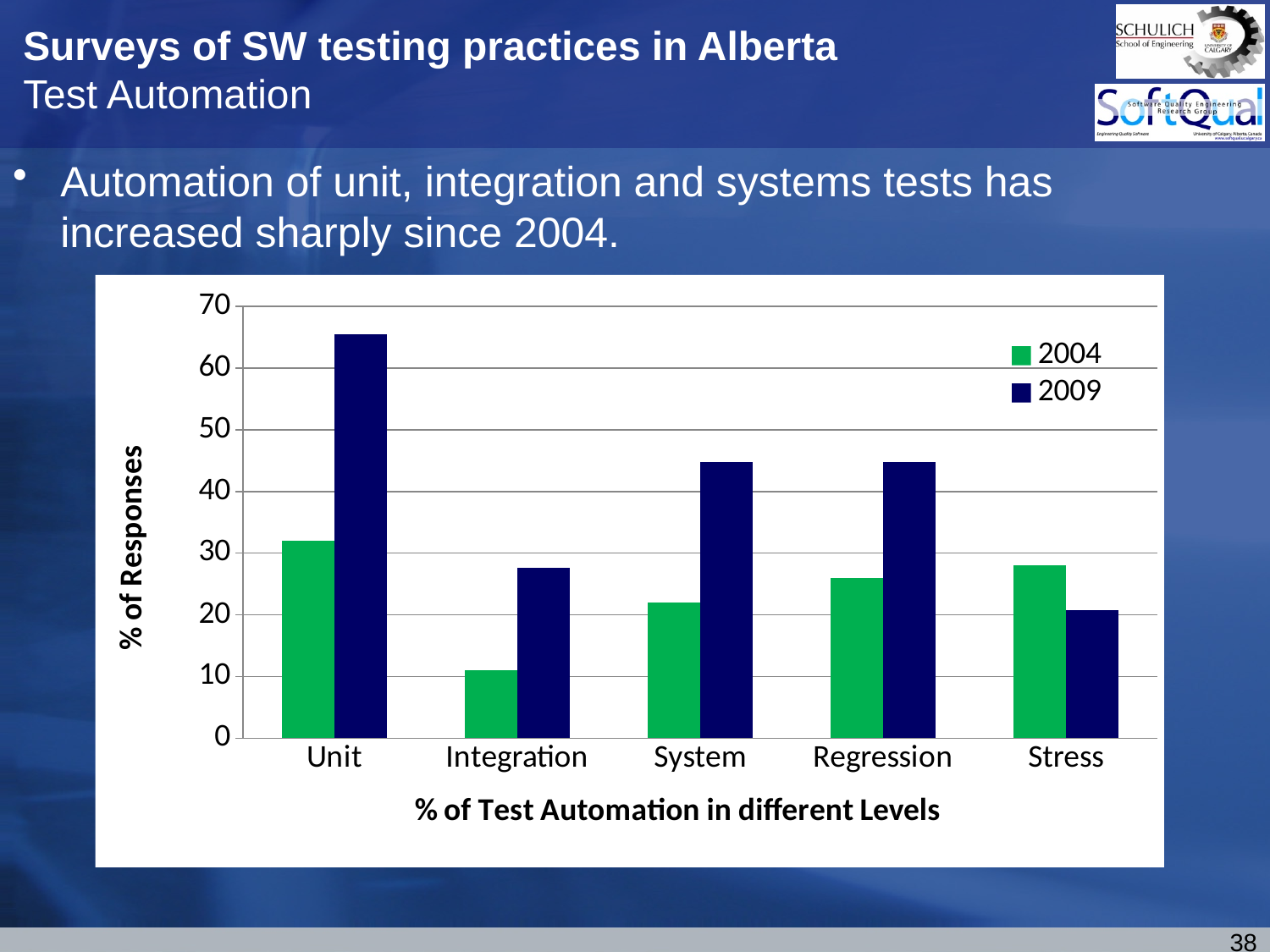
Which is larger, the 2009 value for Unit or the 2009 value for System? Unit Which test level has the highest value for 2009? Unit For Stress, which series has the larger value, 2004 or 2009? 2004 What is the title of the y axis? % of Responses Which test level has the lowest value for 2004? Integration How many series does the legend list? 2 Which test level has the lowest value for 2009? Stress Is the 2009 value for System greater or less than 40? greater Is the 2004 value for Integration greater or less than 20? less Is the 2009 value for Unit greater or less than 60? greater How many test levels (categories) are shown on the x axis? 5 What kind of chart is shown on the slide? bar chart